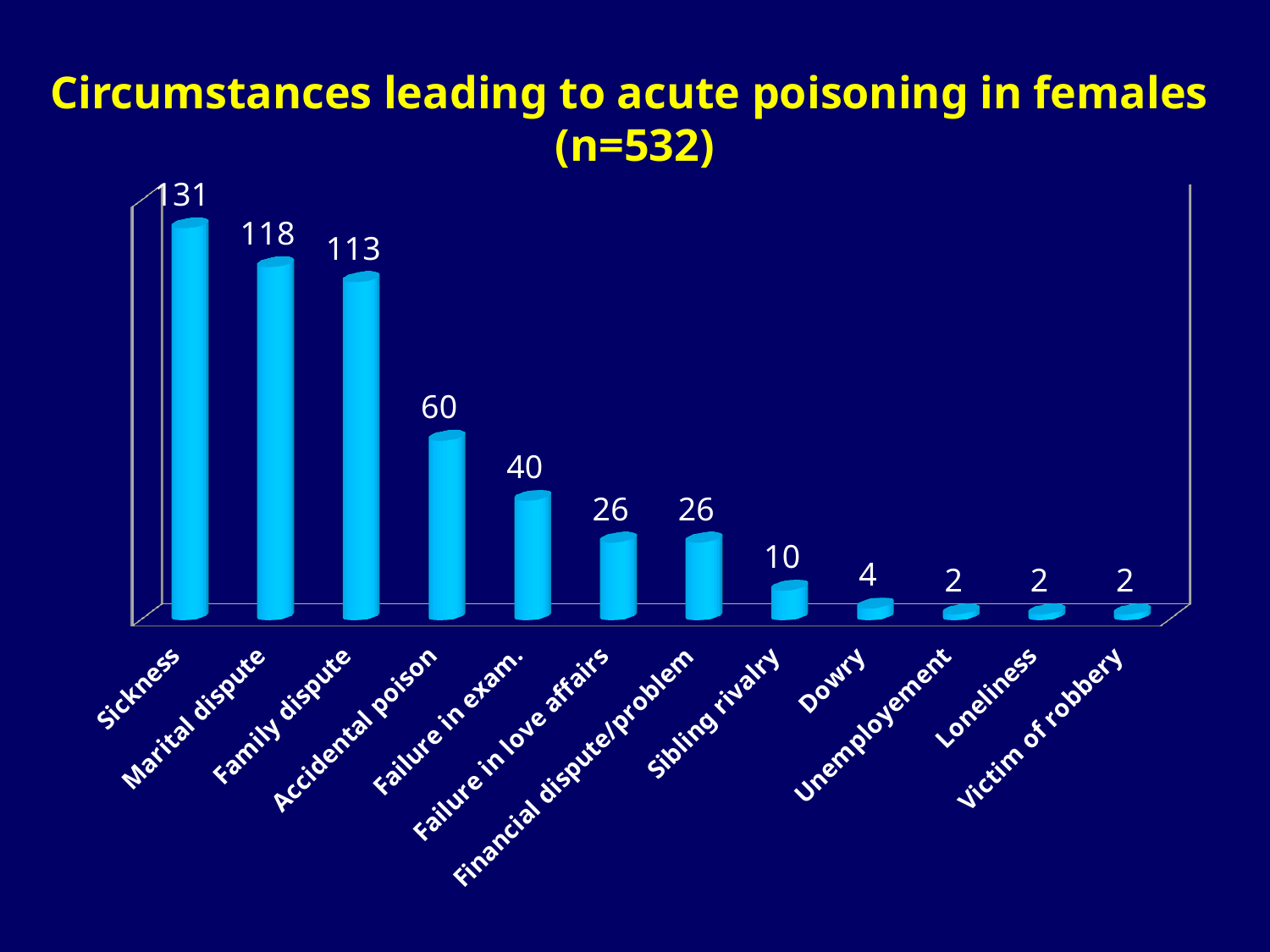
What is the difference between the values for Family dispute and Accidental poison? 53 What kind of chart is shown on the slide? Bar chart Which circumstance has the highest value? Sickness What is the value for Dowry? 4 Which is larger, the value for Failure in exam. or the value for Failure in love affairs? Failure in exam. What is the difference between the values for Sickness and Marital dispute? 13 What is the value for Sibling rivalry? 10 What is the value for Accidental poison? 60 How many categories are shown on the x axis? 12 What is the value for Sickness? 131 Do the values rise or fall from left to right along the x axis? Fall What is the title of the chart? Circumstances leading to acute poisoning in females (n=532)